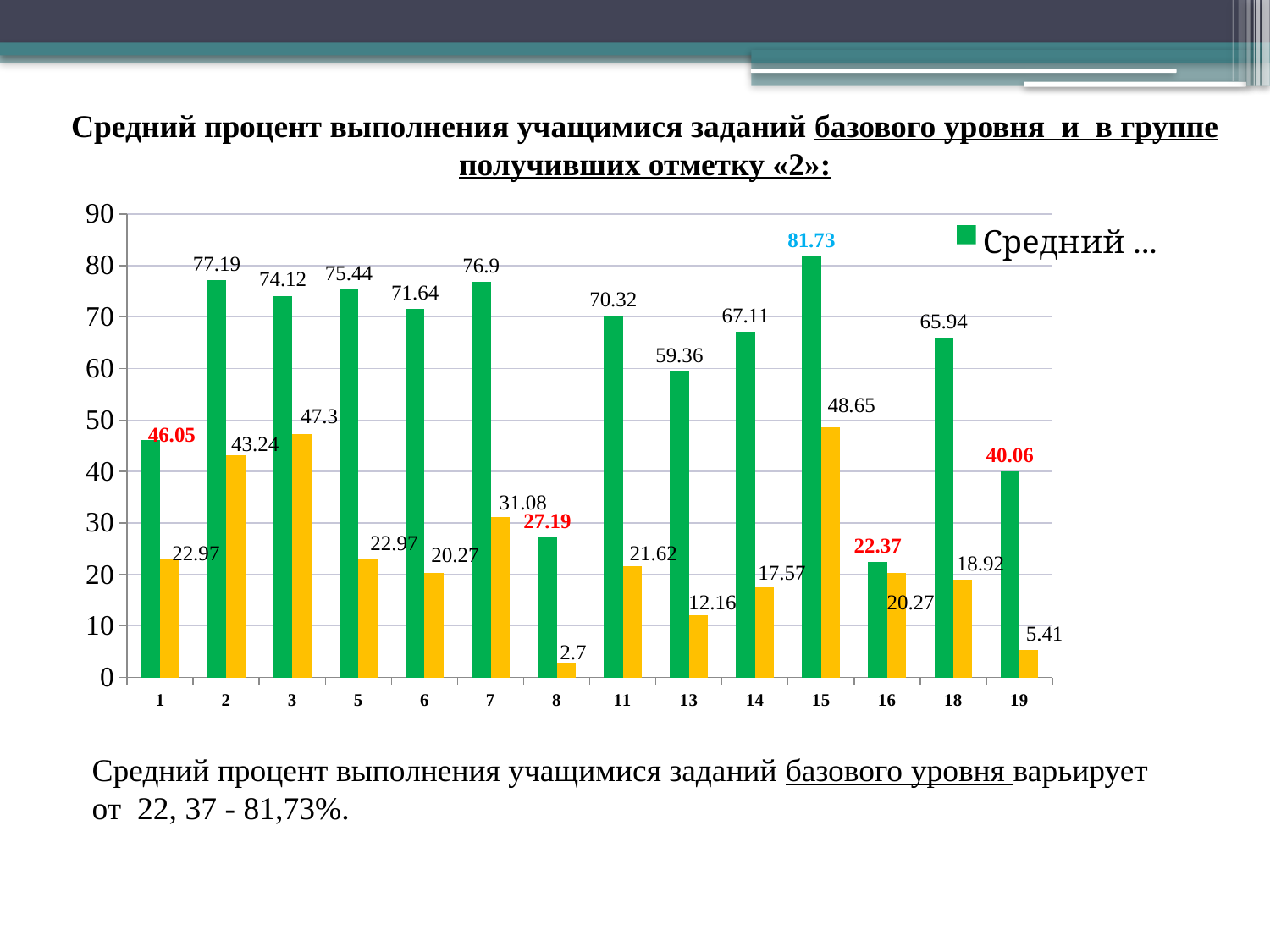
Which category has the highest green bar? 15 How many categories are shown on the x axis? 14 Which has the larger green bar, category 2 or category 7? 2 What is the value of the yellow bar for category 19? 5.41 What is the difference between the green bar and the yellow bar for category 1? 23.08 What is the value of the green bar for category 15? 81.73 Which category has the lowest yellow bar? 8 Which category has the lowest green bar? 16 What is the difference between the green bar for category 15 and the green bar for category 16? 59.36 Which category has the highest yellow bar? 15 What is the value of the yellow bar for category 8? 2.7 What kind of chart is shown on the slide? bar chart